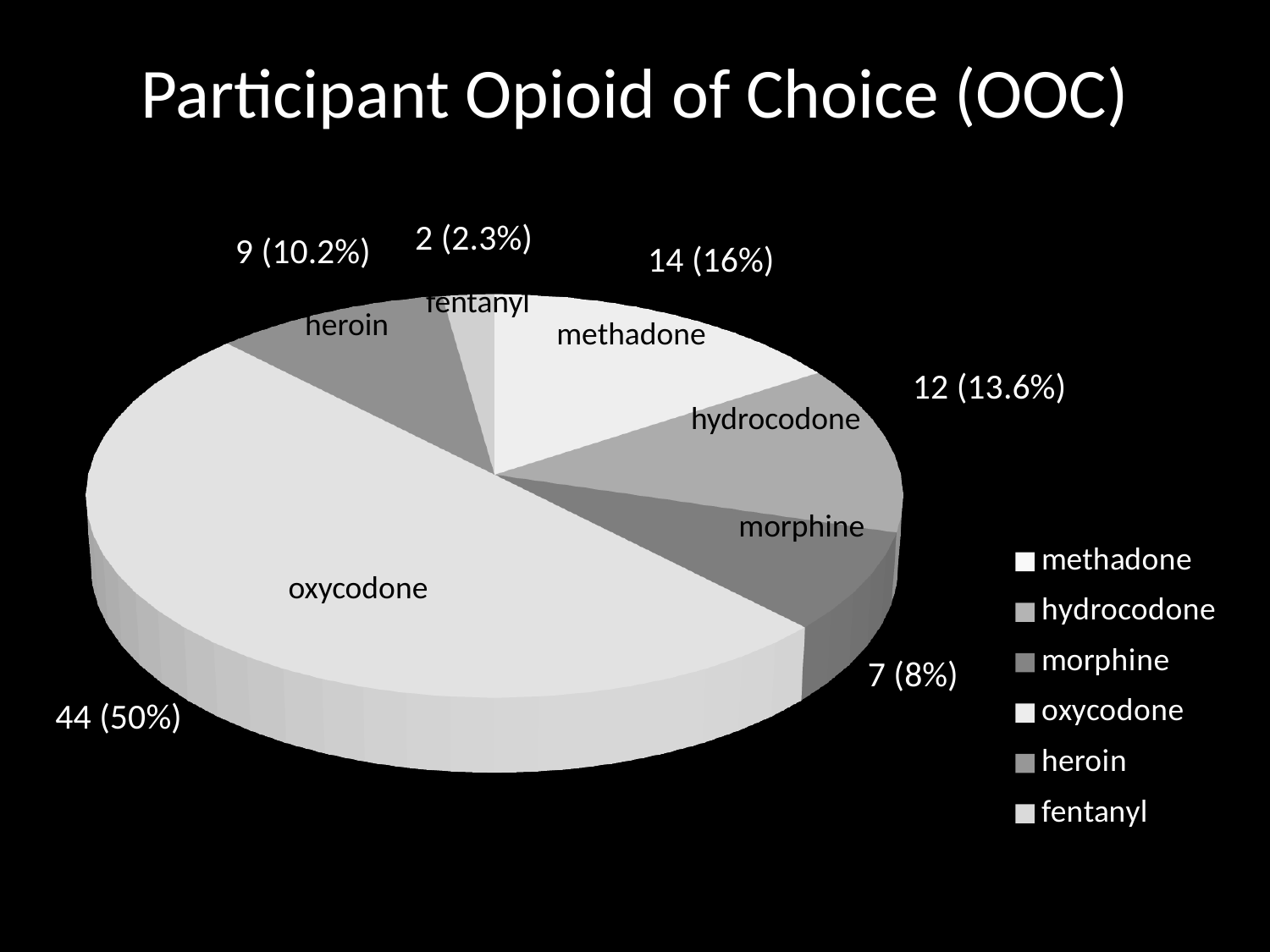
How many slices does the pie chart have? 6 What is the title of the chart? Participant Opioid of Choice (OOC) Which opioid has the smallest slice? fentanyl What share of the pie does heroin represent? 10.2% What kind of chart is shown on the slide? pie chart What is the value shown for hydrocodone? 12 (13.6%) What is the difference in count between methadone and morphine? 7 Which opioid has the largest slice? oxycodone What is the value shown for fentanyl? 2 (2.3%) How many entries does the legend list? 6 What is the value shown for oxycodone? 44 (50%) What is the value shown for methadone? 14 (16%)